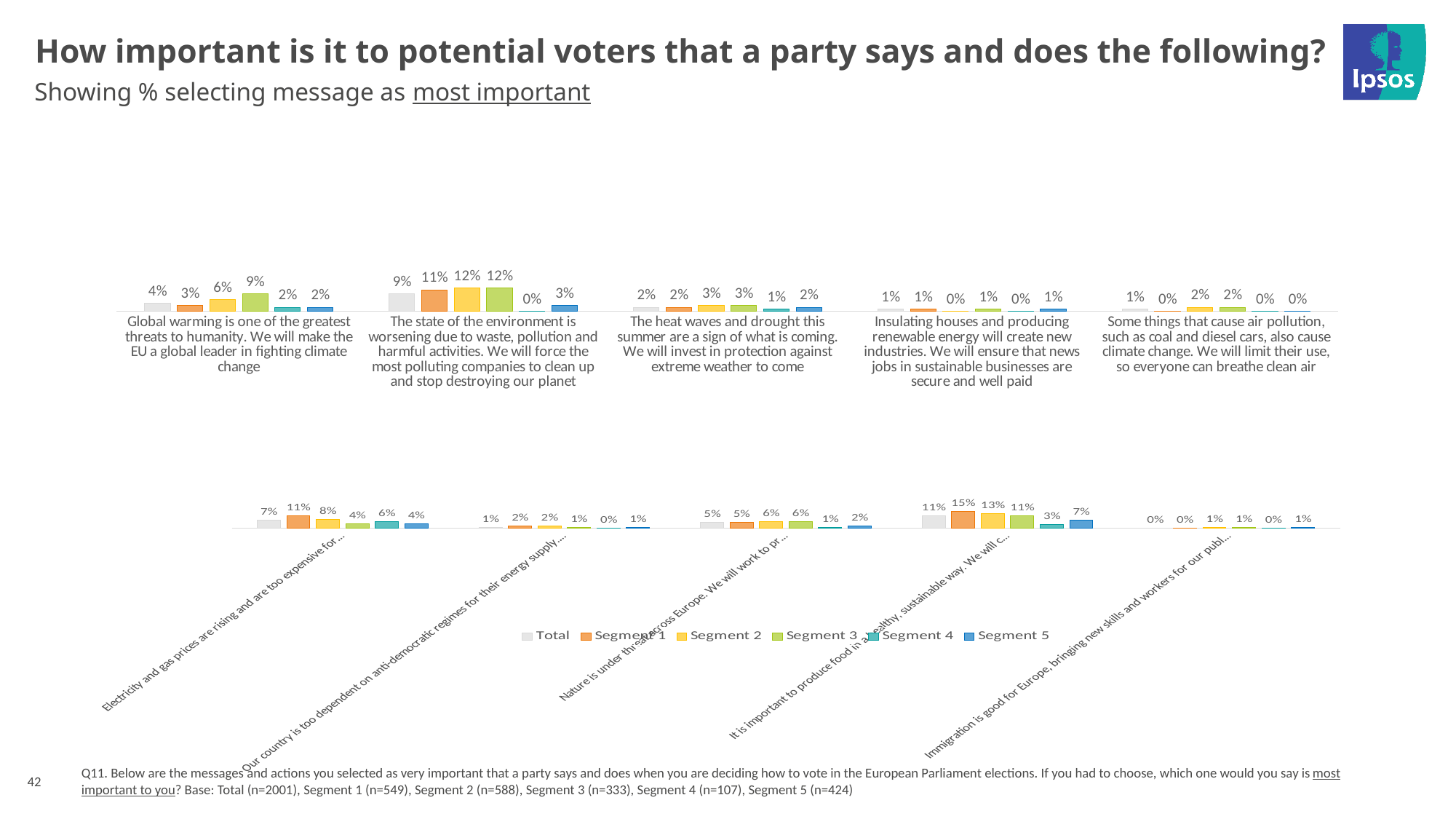
How many series does the legend list? 6 In the top chart, for 'The heat waves and drought this summer are a sign of what is coming...', which is larger: the Segment 2 value or the Segment 4 value? Segment 2 In the bottom chart, which message has the highest Total value? It is important to produce food... In the bottom chart, what is the difference between the Segment 1 and Segment 4 values for the message beginning 'It is important to produce food...'? 12% In the top chart, what is the Total value for the message 'The state of the environment is worsening due to waste, pollution and harmful activities...'? 9% In the top chart, what is the difference between the Segment 2 and Segment 5 values for 'The state of the environment is worsening...'? 9% In the top chart, what is the Segment 4 value for 'The state of the environment is worsening...'? 0% In the bottom chart, what is the Segment 1 value for the message beginning 'It is important to produce food...'? 15% In the bottom chart, what is the Total value for the message beginning 'Electricity and gas prices are rising...'? 7% What kind of chart is the top chart? Bar chart In the top chart, what is the Segment 3 value for 'Global warming is one of the greatest threats to humanity...'? 9% In the top chart, which message has the highest Total value? The state of the environment is worsening due to waste, pollution and harmful activities. We will force the most polluting companies to clean up and stop destroying our planet